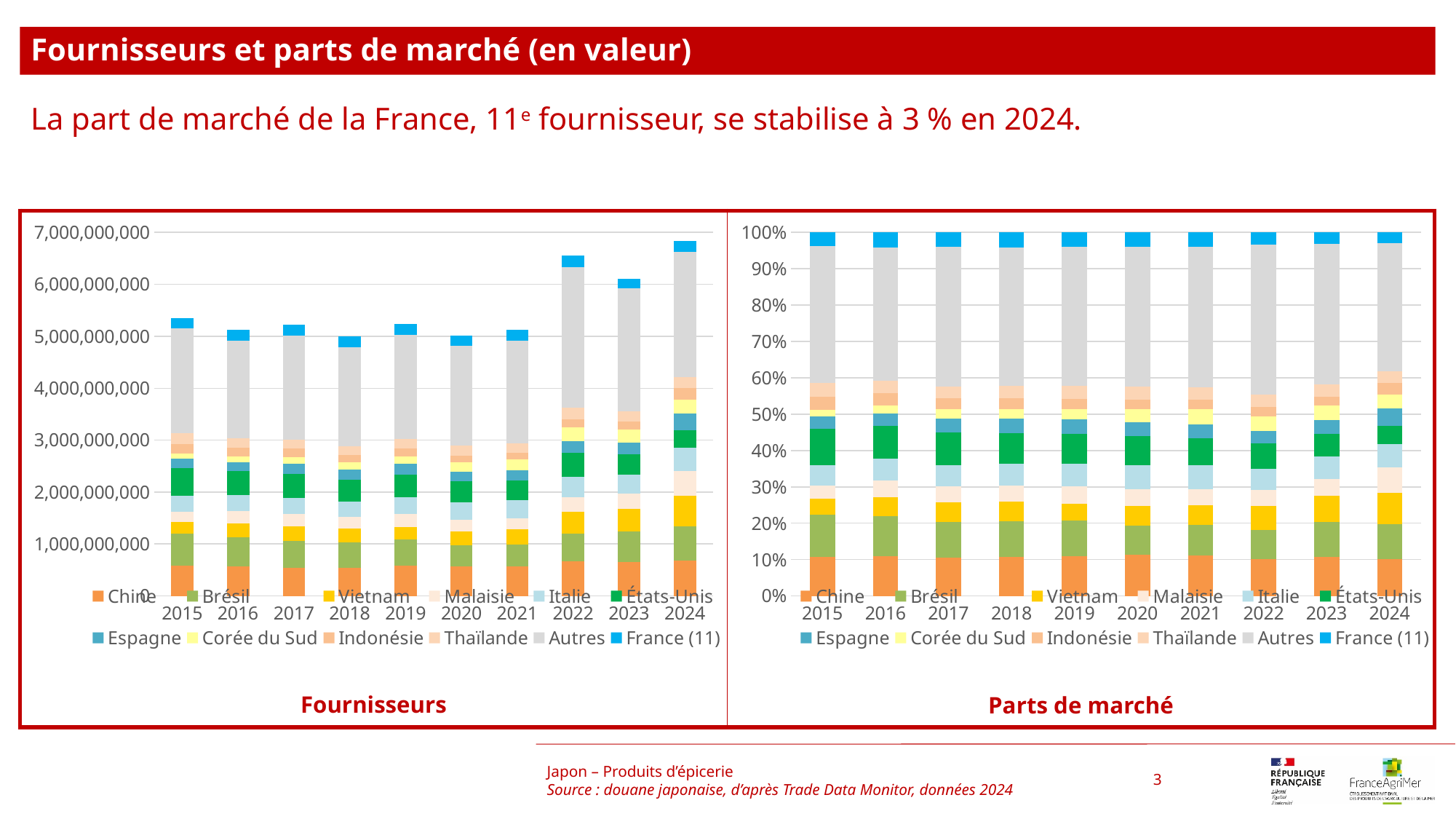
In the 'Fournisseurs' chart, is the total for 2024 greater or less than 6,000,000,000? greater In the 'Fournisseurs' chart, is the total for 2018 greater or less than 6,000,000,000? less In the 'Fournisseurs' chart, which year has the highest total bar? 2024 What kind of chart is the 'Fournisseurs' chart on the left? stacked bar chart In the 'Parts de marché' chart, is the Chine segment for 2024 greater or less than 20%? less In the 'Fournisseurs' chart, which total bar is larger, 2022 or 2023? 2022 How many years are shown on the x axis of the 'Fournisseurs' chart? 10 In the 'Parts de marché' chart, what is the total of the 2024 stacked bar? 100% What is the title of the chart on the right? Parts de marché How many series does the legend of the 'Parts de marché' chart list? 12 Which series is listed last in the legend of the 'Fournisseurs' chart? France (11)